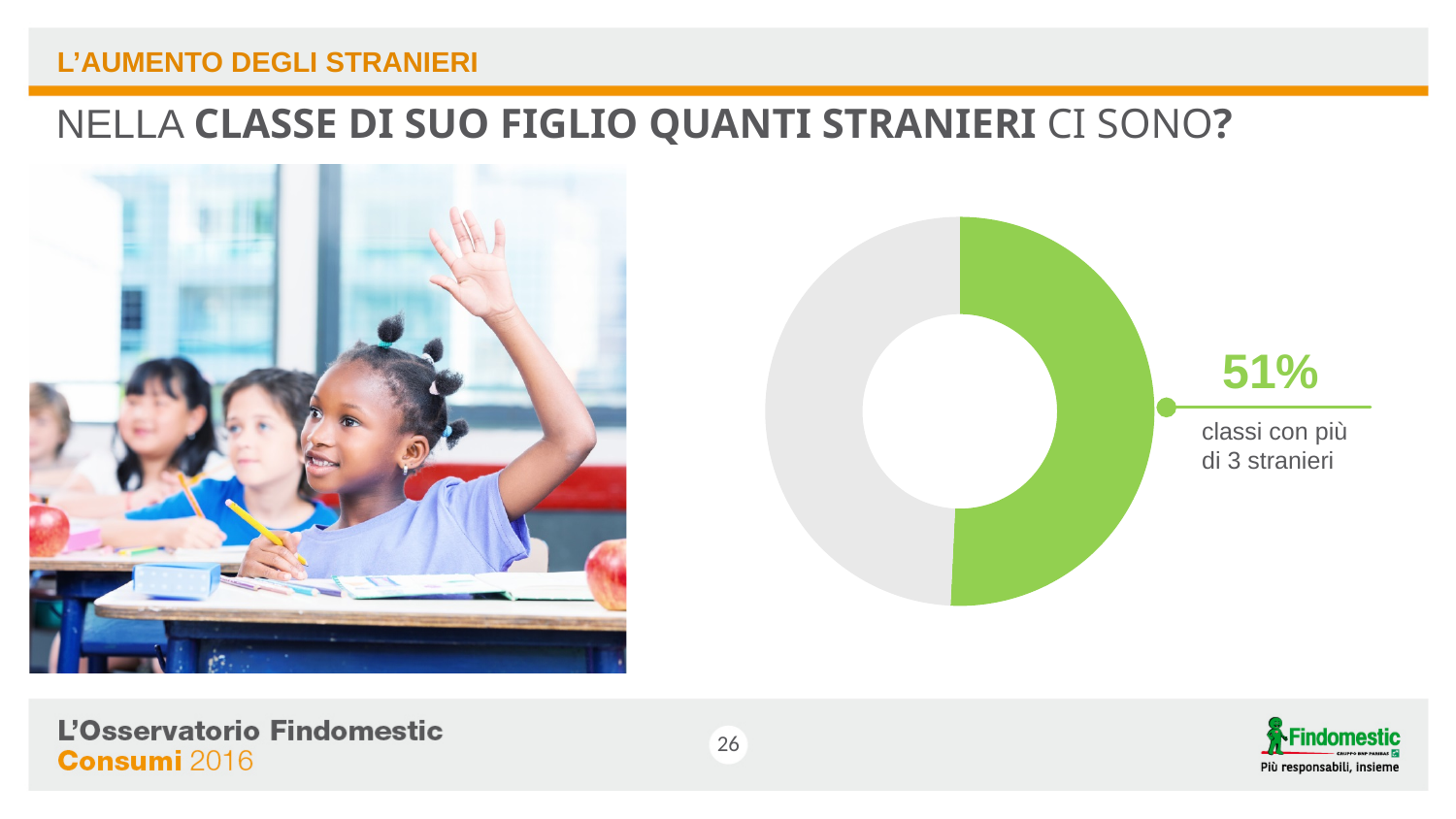
What share of the donut chart does the green slice represent? 51% What question does the slide title ask about the chart? Nella classe di suo figlio quanti stranieri ci sono? Is the share of classes with more than 3 foreign students greater or less than 50%? greater What colour is the slice labelled 'classi con più di 3 stranieri'? Green What percentage of classes have more than 3 foreign students according to the donut chart? 51% How many slices does the donut chart have? 2 What kind of chart is shown on the slide? Donut (pie) chart